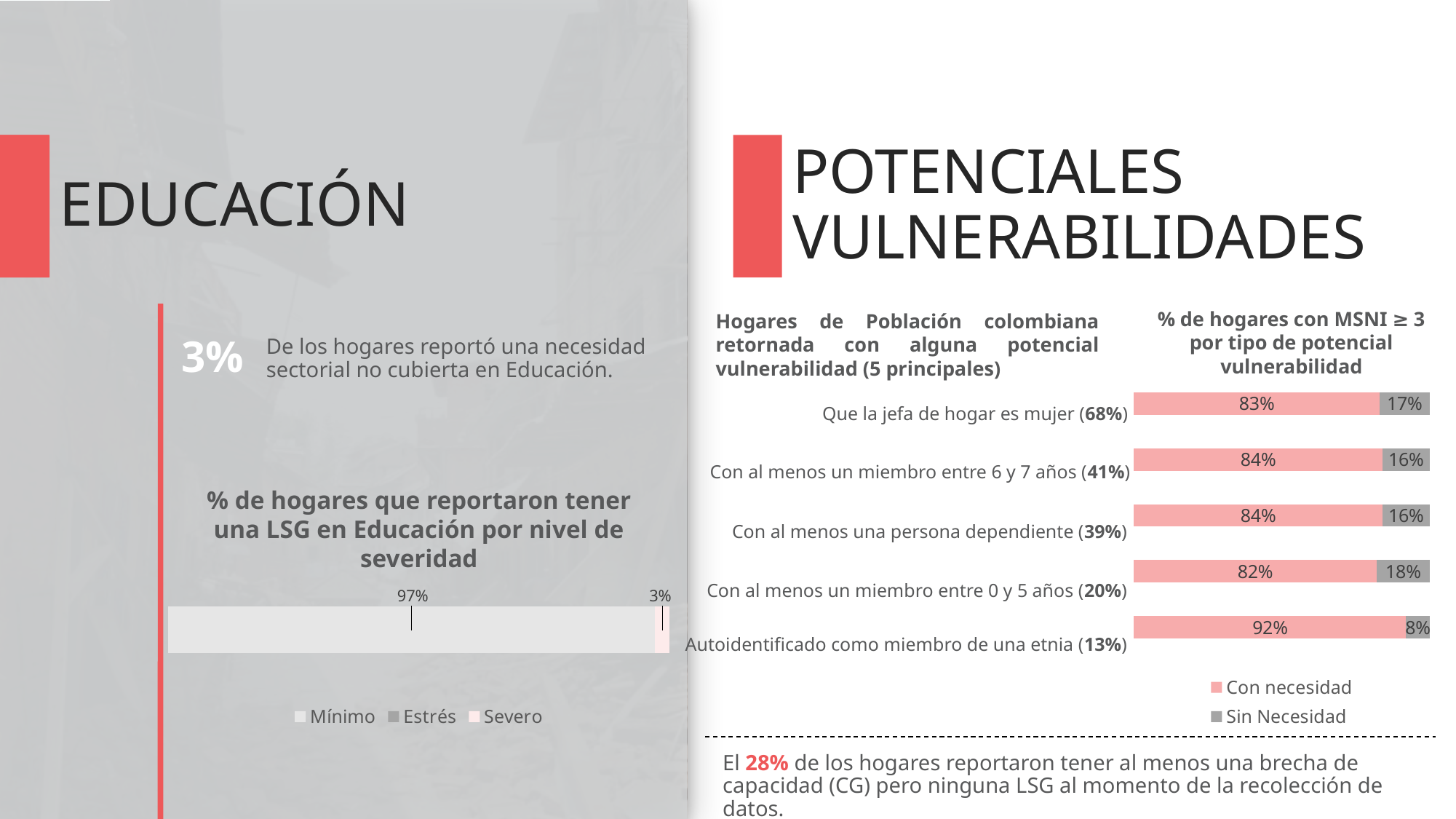
In the chart '% de hogares con MSNI ≥ 3 por tipo de potencial vulnerabilidad', which category has the highest 'Con necesidad' value? Autoidentificado como miembro de una etnia In the chart '% de hogares con MSNI ≥ 3 por tipo de potencial vulnerabilidad', which is larger: the 'Sin Necesidad' value for 'Con al menos un miembro entre 0 y 5 años' or for 'Con al menos una persona dependiente'? Con al menos un miembro entre 0 y 5 años In the chart '% de hogares con MSNI ≥ 3 por tipo de potencial vulnerabilidad', what is the 'Con necesidad' value for 'Autoidentificado como miembro de una etnia'? 92% How many series does the legend list in the chart '% de hogares con MSNI ≥ 3 por tipo de potencial vulnerabilidad'? 2 In the chart '% de hogares con MSNI ≥ 3 por tipo de potencial vulnerabilidad', what is the 'Sin Necesidad' value for 'Que la jefa de hogar es mujer'? 17% In the chart '% de hogares que reportaron tener una LSG en Educación por nivel de severidad', what is the value for 'Mínimo'? 97% In the chart '% de hogares con MSNI ≥ 3 por tipo de potencial vulnerabilidad', what is the difference between the 'Con necesidad' values for 'Autoidentificado como miembro de una etnia' and 'Con al menos un miembro entre 0 y 5 años'? 10% In the chart '% de hogares con MSNI ≥ 3 por tipo de potencial vulnerabilidad', which category has the lowest 'Con necesidad' value? Con al menos un miembro entre 0 y 5 años What kind of chart is '% de hogares con MSNI ≥ 3 por tipo de potencial vulnerabilidad'? Stacked bar chart In the chart '% de hogares que reportaron tener una LSG en Educación por nivel de severidad', what is the value for 'Severo'? 3% How many categories are shown in the chart '% de hogares con MSNI ≥ 3 por tipo de potencial vulnerabilidad'? 5 How many series does the legend list in the chart '% de hogares que reportaron tener una LSG en Educación por nivel de severidad'? 3